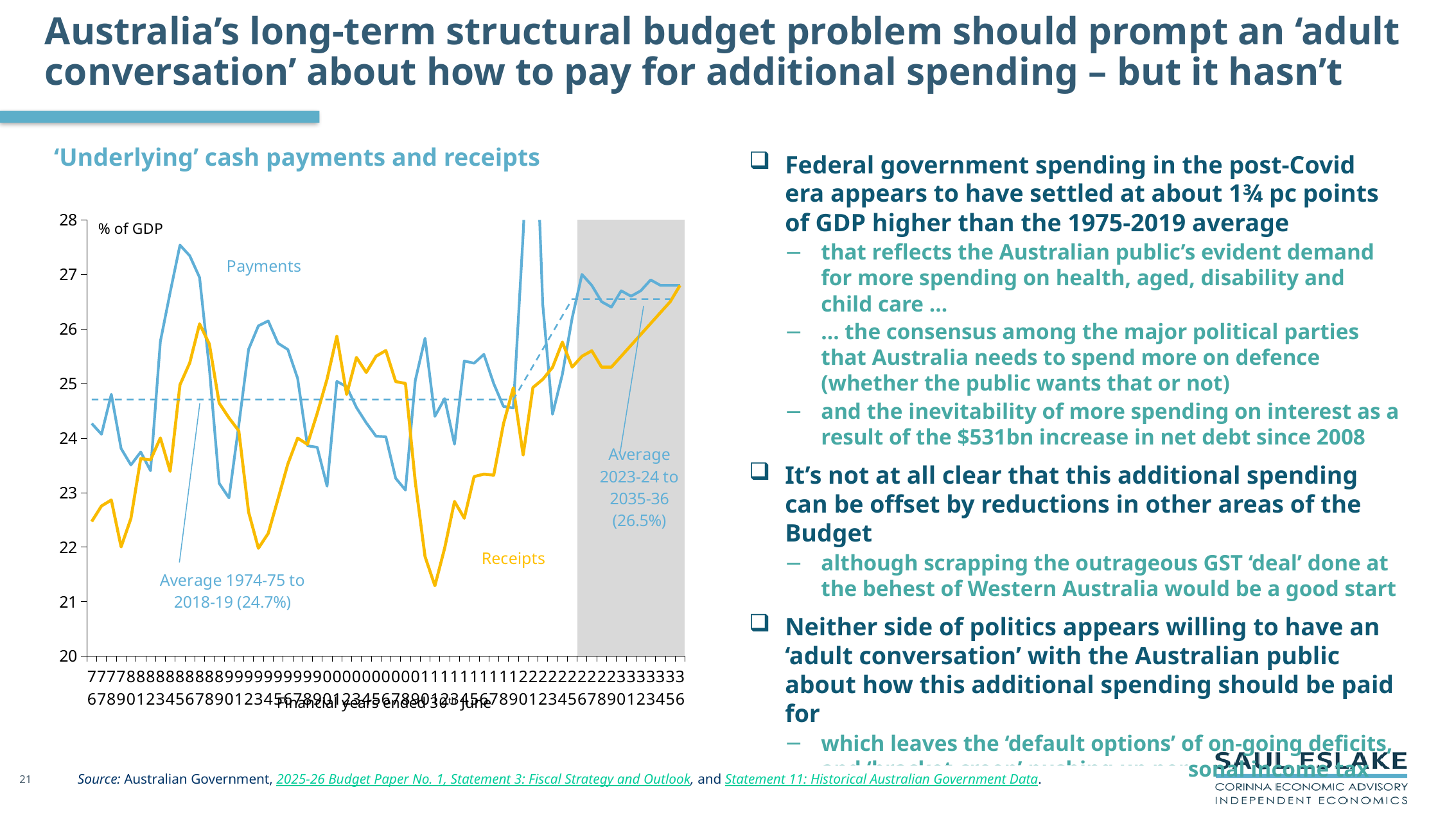
What type of chart is shown on the slide? Line chart Is the lowest value of the Receipts line greater or less than 22? less Which series reaches the highest value on the chart? Payments Which is higher: the 1974-75 to 2018-19 average or the 2023-24 to 2035-36 average? 2023-24 to 2035-36 average Do Receipts rise or fall across the shaded projection period at the right of the chart? rise Which series reaches the lowest value on the chart? Receipts By how many percentage points does the 2023-24 to 2035-36 average exceed the 1974-75 to 2018-19 average? 1.8 percentage points What is the average level of payments for 1974-75 to 2018-19 shown on the chart? 24.7% What is the average level of payments for 2023-24 to 2035-36 shown on the chart? 26.5% Is the peak value of the Payments line greater or less than 27? greater What unit is shown on the vertical axis of the chart? % of GDP